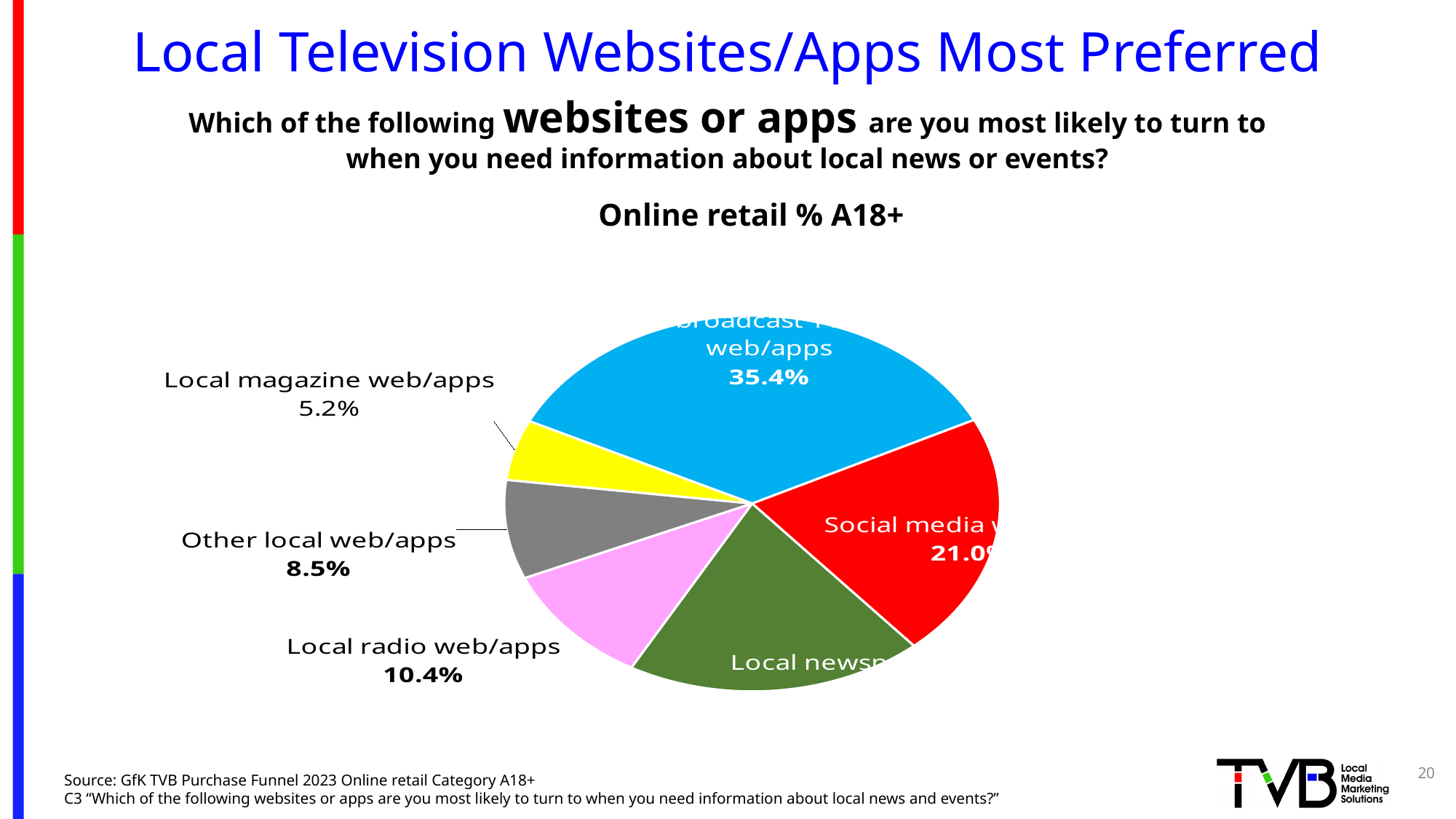
What percentage is shown for Local radio web/apps? 10.4% Which category has the smallest slice of the pie? Local magazine web/apps How many percentage points higher is Other local web/apps than Local magazine web/apps? 3.3 Is the blue slice larger or smaller than the red slice? larger How many percentage points higher is Local radio web/apps than Other local web/apps? 1.9 What percentage is shown for Local magazine web/apps? 5.2% What percentage is shown for Other local web/apps? 8.5% What is the title of the pie chart? Online retail % A18+ What value is printed on the largest (blue) slice of the pie? 35.4% Which is larger, Local radio web/apps or Other local web/apps? Local radio web/apps How many slices does the pie chart have? 6 What kind of chart is shown on the slide? pie chart